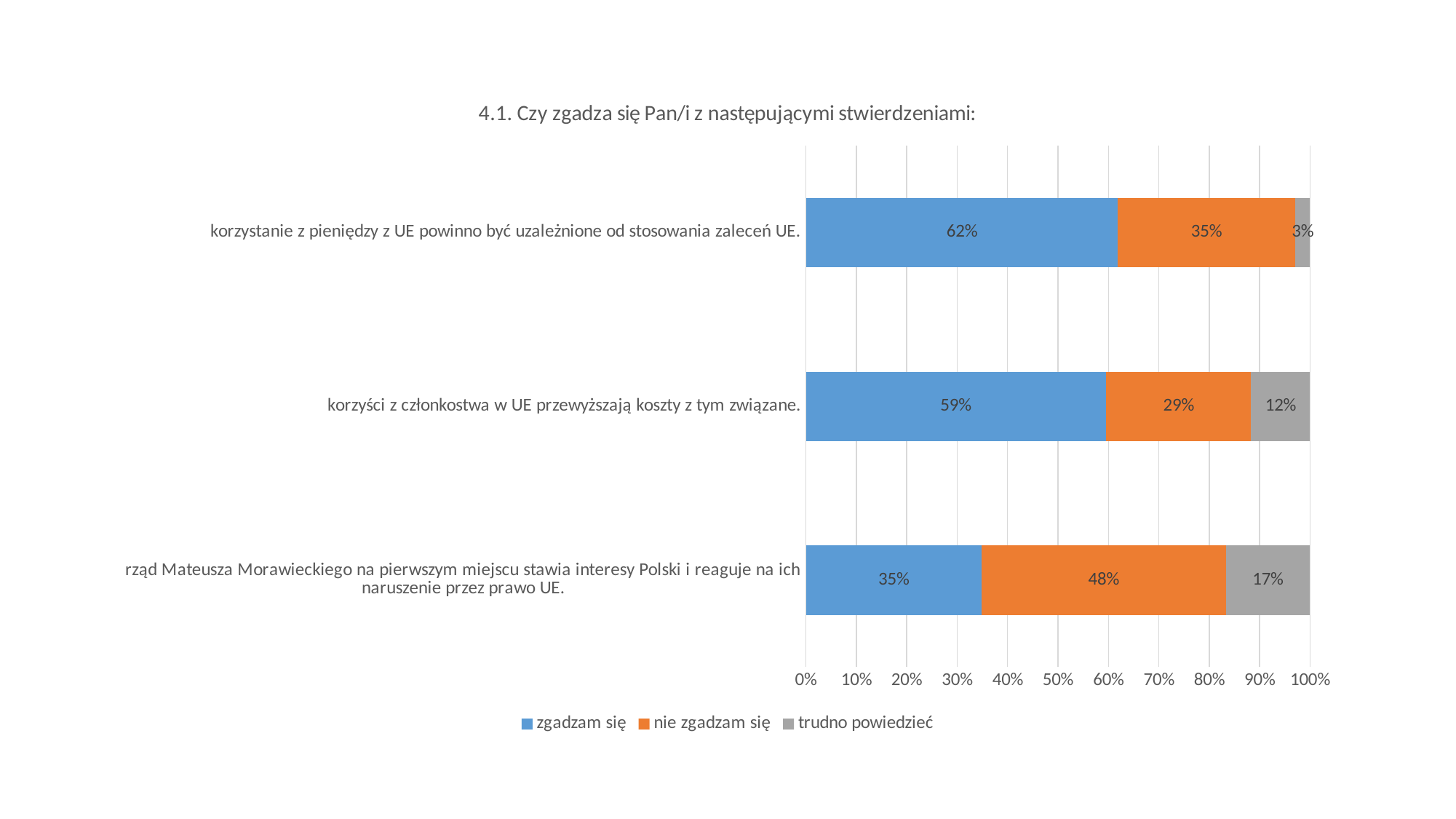
What percentage of respondents disagree ("nie zgadzam się") with the statement that the government of Mateusz Morawiecki puts Poland's interests first? 48% How many series does the legend list? 3 What percentage of respondents agree ("zgadzam się") that the benefits of EU membership outweigh the costs ("korzyści z członkostwa w UE przewyższają koszty z tym związane")? 59% Which statement has the highest share of "zgadzam się" responses? korzystanie z pieniędzy z UE powinno być uzależnione od stosowania zaleceń UE. What is the difference in percentage points between "nie zgadzam się" and "zgadzam się" for the statement about the Morawiecki government? 13 percentage points For the statement about EU membership benefits outweighing costs, which is larger: the "zgadzam się" share or the "nie zgadzam się" share? zgadzam się What type of chart is shown on the slide? Stacked bar chart What percentage answered "trudno powiedzieć" for the statement that using EU money should depend on following EU recommendations? 3% Which colour represents "nie zgadzam się" in the chart? Orange What is the total of the stacked bar for the statement about the Morawiecki government? 100% How many statements (categories) are shown in the chart? 3 Which statement has the lowest share of "trudno powiedzieć" responses? korzystanie z pieniędzy z UE powinno być uzależnione od stosowania zaleceń UE.